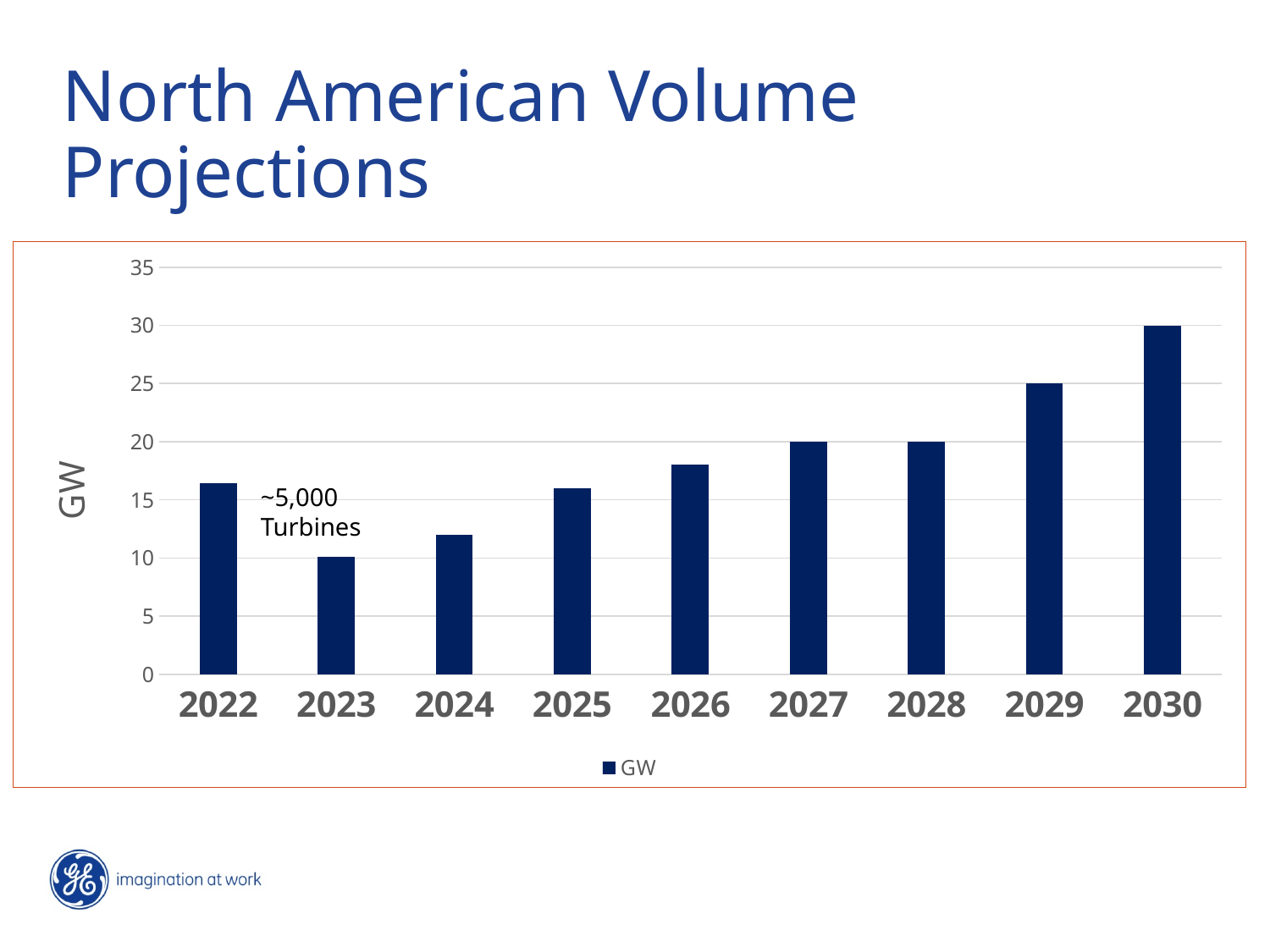
What is the label on the chart's vertical axis? GW Which year has the lowest projected volume? 2023 How many series does the chart's legend list? 1 Is the projected volume for 2026 greater or less than 20 GW? less Is the projected volume for 2022 greater or less than 15 GW? greater Which year has the larger projected volume, 2022 or 2023? 2022 How many years are plotted on the x axis of the chart? 9 Do the projected volumes generally rise or fall from 2023 to 2030? rise What kind of chart is shown on the slide? bar chart Is the projected volume for 2029 greater or less than 20 GW? greater Which year has the highest projected volume? 2030